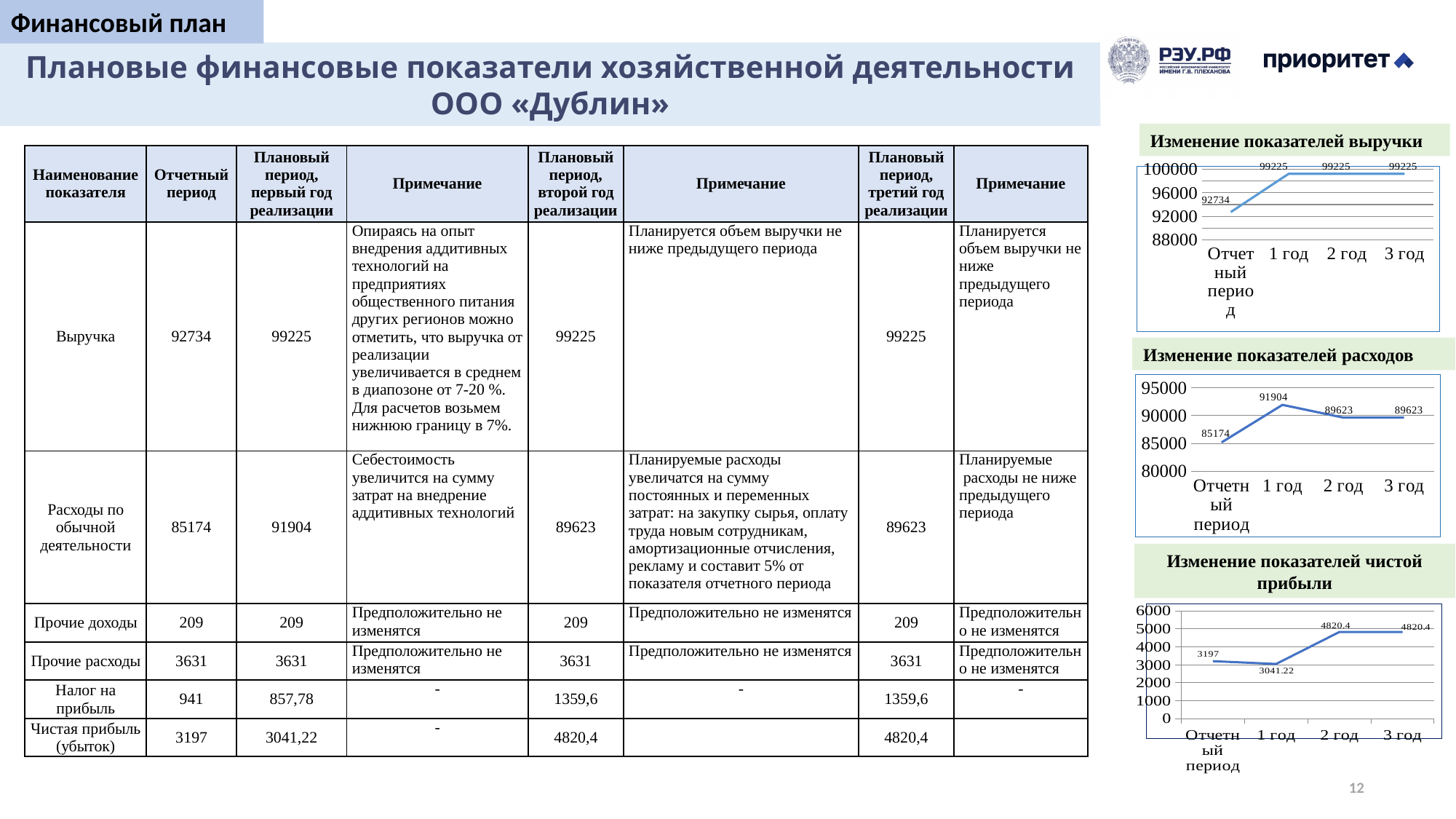
In the chart 'Изменение показателей расходов', what is the difference between the value for '1 год' and the value for '2 год'? 2281 What kind of chart is 'Изменение показателей выручки'? line chart In the chart 'Изменение показателей выручки', what is the value for 'Отчетный период'? 92734 In the chart 'Изменение показателей чистой прибыли', is the value for '3 год' greater or less than 4000? greater How many data points are plotted in the chart 'Изменение показателей чистой прибыли'? 4 In the chart 'Изменение показателей чистой прибыли', which is larger: the value for 'Отчетный период' or the value for '1 год'? Отчетный период In the chart 'Изменение показателей чистой прибыли', what is the value for '1 год'? 3041.22 In the chart 'Изменение показателей выручки', what is the difference between the value for '1 год' and the value for 'Отчетный период'? 6491 In the chart 'Изменение показателей расходов', which period has the highest value? 1 год In the chart 'Изменение показателей расходов', what is the value for '2 год'? 89623 In the chart 'Изменение показателей расходов', which period has the lowest value? Отчетный период In the chart 'Изменение показателей выручки', what is the value for '1 год'? 99225